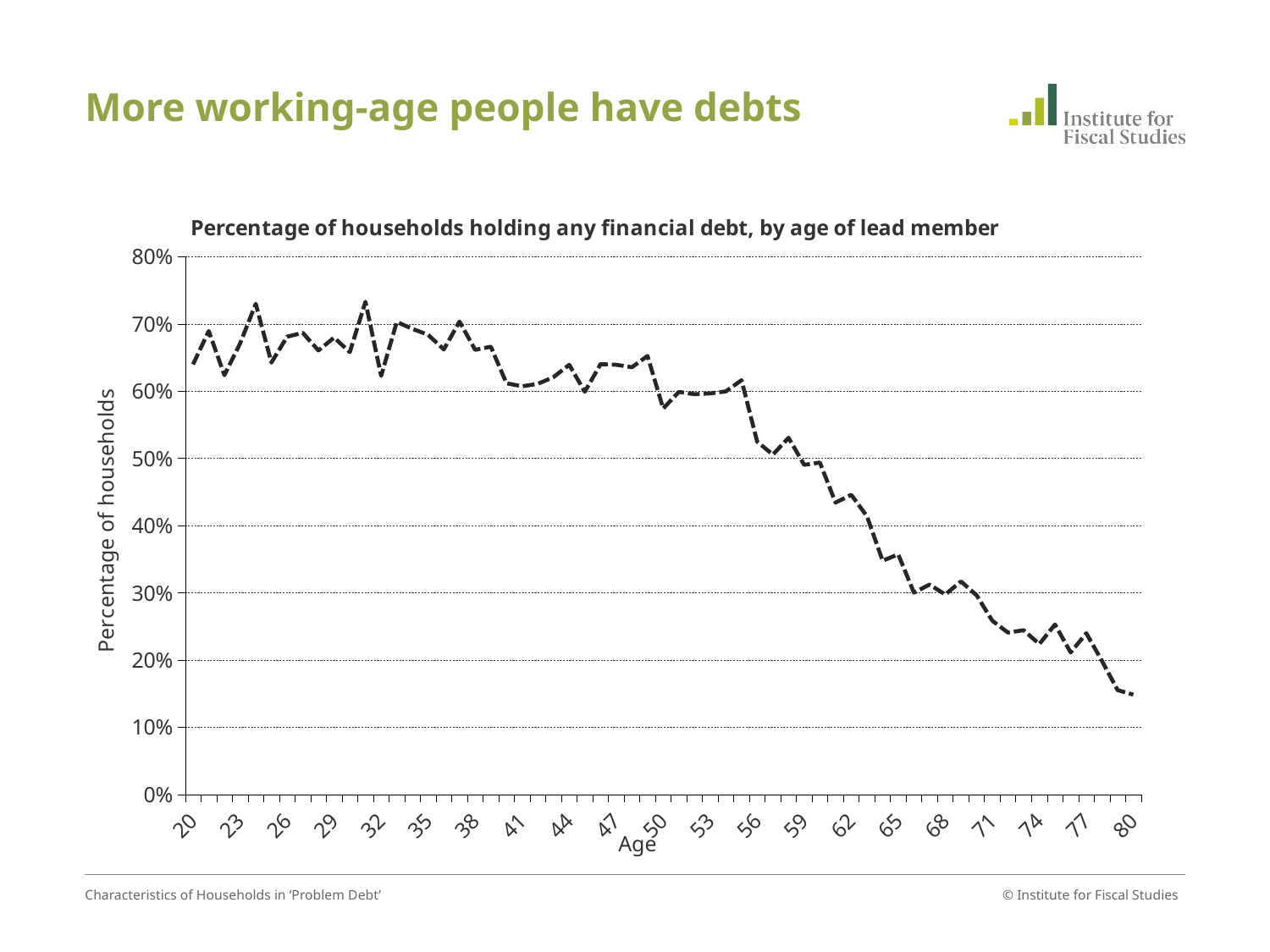
Which age has the lowest percentage of households holding any financial debt? 80 Is the value for age 80 greater or less than 20%? less Is the value for age 65 greater or less than 40%? less Is the value for age 44 greater or less than 60%? greater What kind of chart is shown on the slide? Line chart Overall, do the values rise or fall as age increases along the x axis? Fall Which is larger, the value for age 35 or the value for age 65? Age 35 What is the label on the vertical axis of the chart? Percentage of households What is the title of the chart? Percentage of households holding any financial debt, by age of lead member